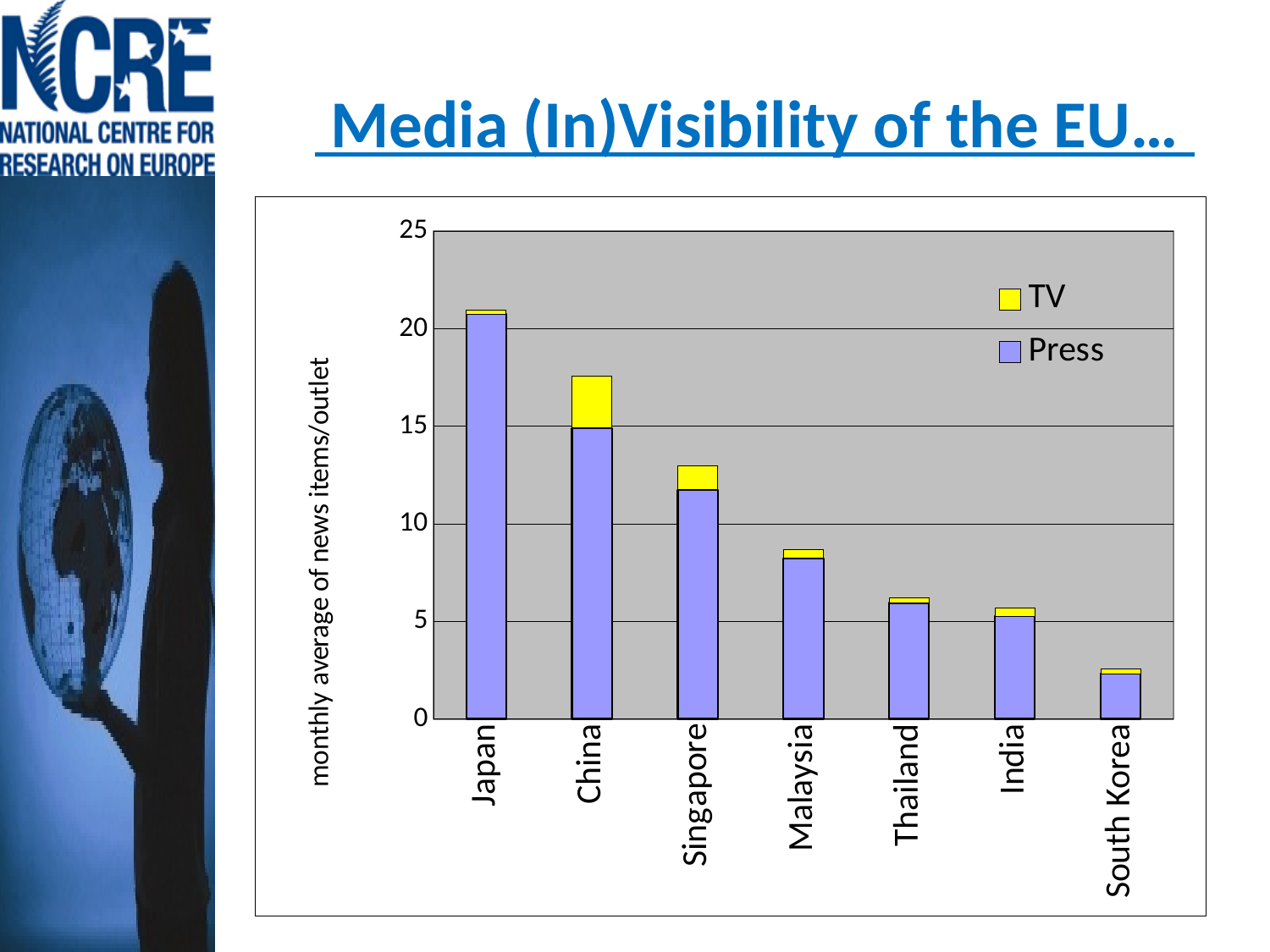
Which country has the lowest total bar in the chart? South Korea How many series does the chart's legend list? 2 Do the total bar values rise or fall moving from Japan to South Korea along the x axis? fall What kind of chart is shown on the slide? stacked bar chart What is the label on the chart's vertical axis? monthly average of news items/outlet Is the Press value for Singapore greater or less than 10? greater Is the total value for China greater or less than 15? greater Is the total value for South Korea greater or less than 5? less How many countries are shown on the x axis of the chart? 7 Which has a larger total bar, Malaysia or Thailand? Malaysia Which country has the highest total bar in the chart? Japan